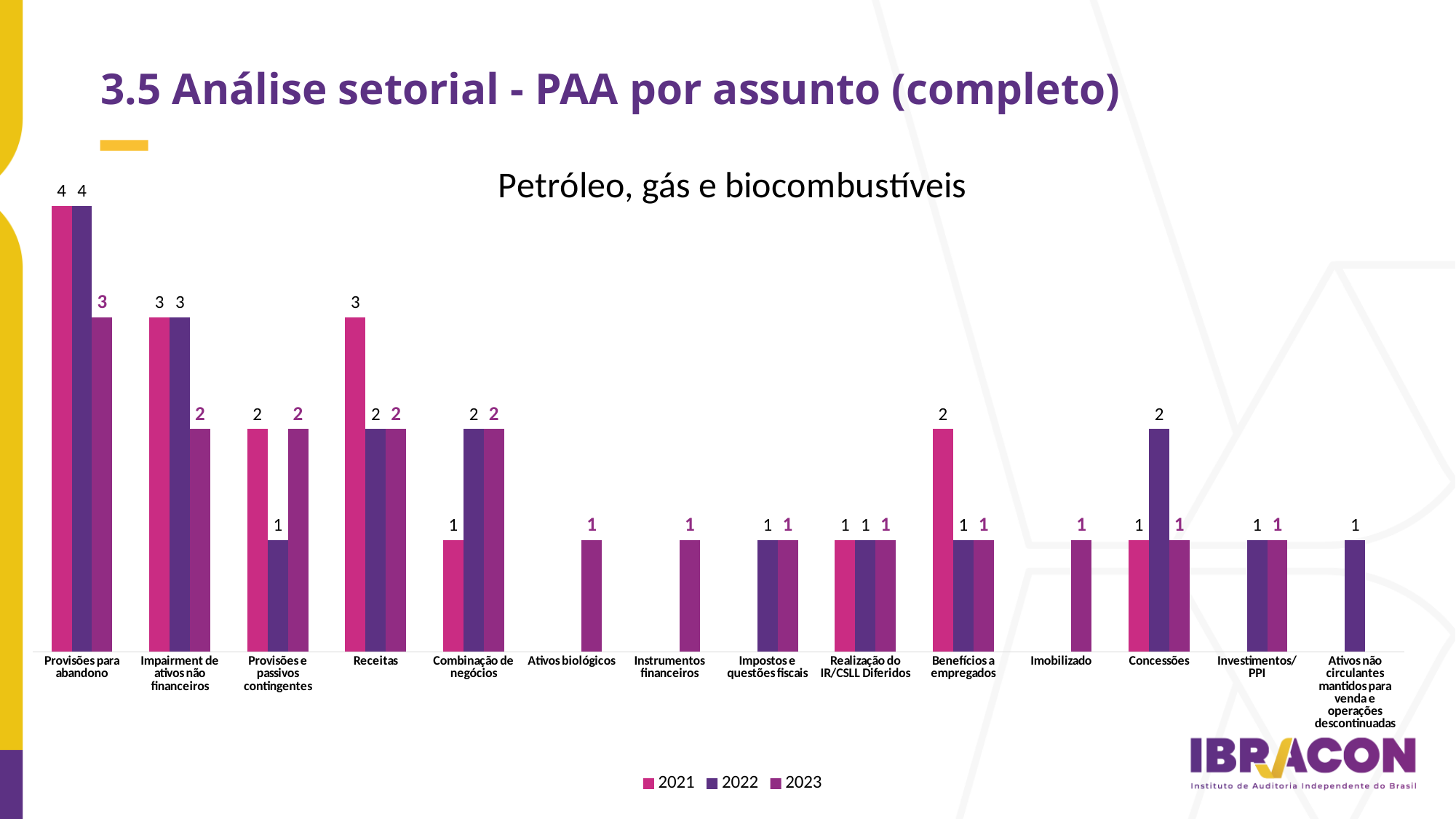
What is the value for 2023 in the category Impairment de ativos não financeiros? 2 What is the title of the chart? Petróleo, gás e biocombustíveis How many series does the legend list? 3 Which category has the highest value for 2021? Provisões para abandono Do the values for Provisões para abandono rise or fall from 2021 to 2023? fall What is the difference between the 2021 and 2023 values for Receitas? 1 What is the value for 2022 in the category Concessões? 2 What is the value for 2021 in the category Provisões para abandono? 4 How many categories are shown on the x axis? 14 What type of chart is shown on the slide? bar chart What is the total of the 2021, 2022 and 2023 values for Provisões para abandono? 11 Which is larger for Combinação de negócios: the 2021 value or the 2022 value? 2022